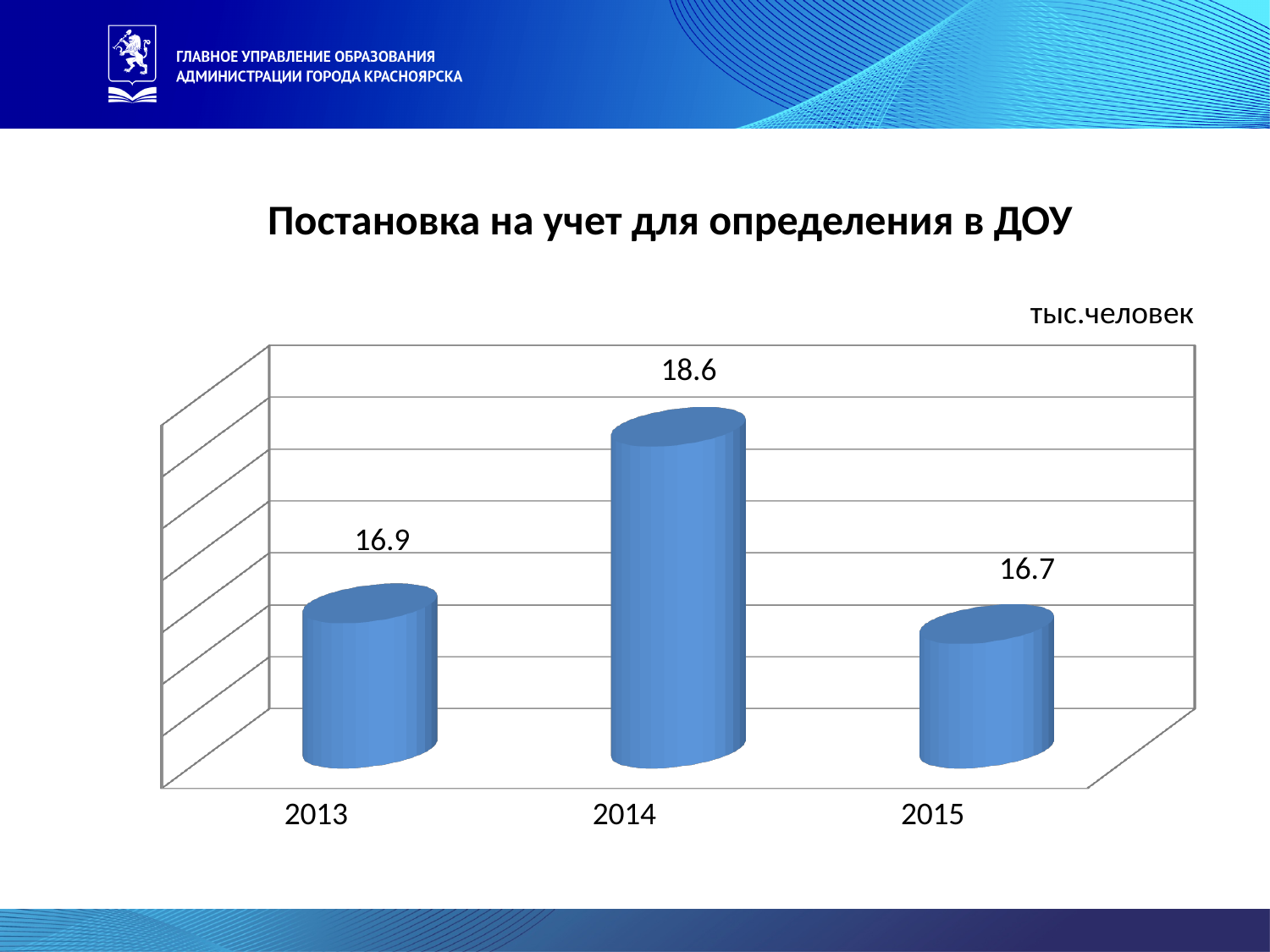
Which year has the lowest value? 2015 How many years are shown on the chart? 3 What is the value for 2013? 16.9 Which is larger, the value for 2014 or the value for 2015? 2014 What is the title of the chart? Постановка на учет для определения в ДОУ What is the difference between the values for 2014 and 2013? 1.7 What is the value for 2014? 18.6 What kind of chart is this? bar chart What is the difference between the values for 2013 and 2015? 0.2 What is the value for 2015? 16.7 Which year has the highest value? 2014 What unit is indicated for the values on the chart? тыс.человек